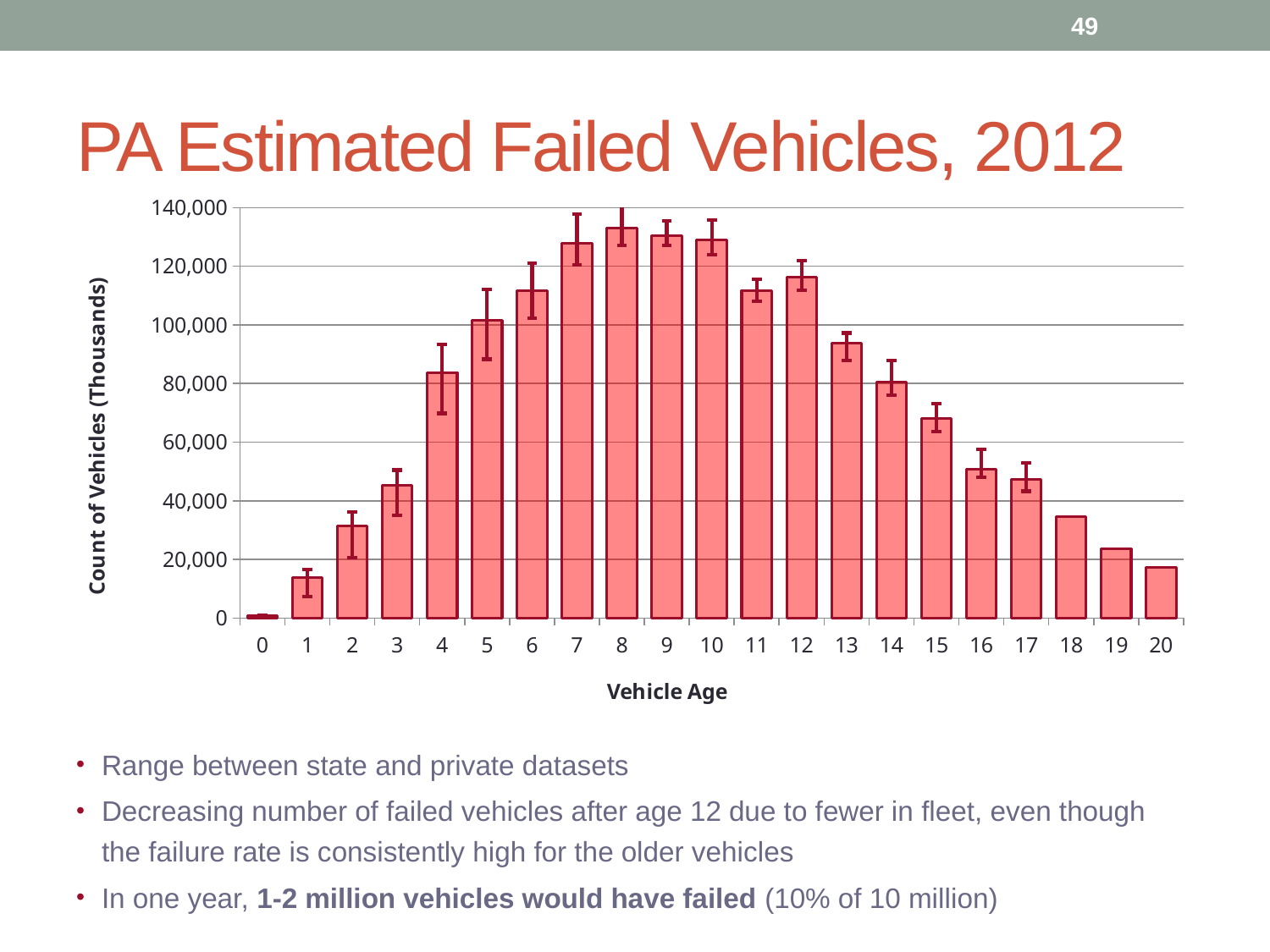
What is the label of the vertical axis? Count of Vehicles (Thousands) What kind of chart is shown on the slide? Bar chart Which has a higher count of failed vehicles, vehicle age 6 or vehicle age 13? Vehicle age 6 What is the title of the chart? PA Estimated Failed Vehicles, 2012 Which vehicle age has the lowest count of failed vehicles? 0 Is the value for vehicle age 7 greater or less than 120,000? greater Is the value for vehicle age 18 greater or less than 40,000? less How many vehicle age categories are plotted on the x axis? 21 Is the value for vehicle age 15 greater or less than 60,000? greater Do the values rise or fall along the x axis from vehicle age 12 to vehicle age 20? Fall